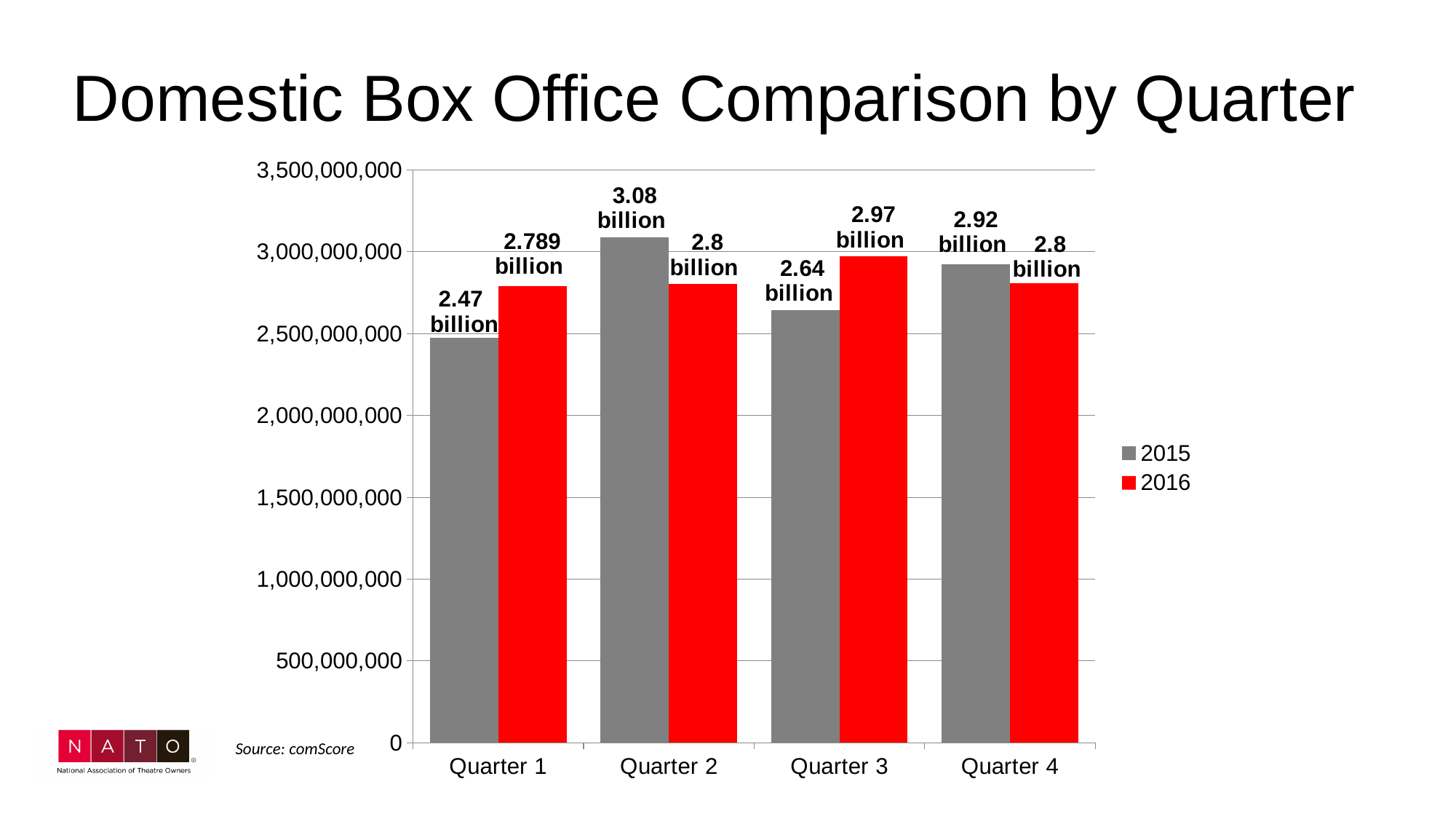
Which quarter has the lowest 2015 value? Quarter 1 Which quarter has the highest 2015 value? Quarter 2 Which quarter has the highest 2016 value? Quarter 3 What is the difference between the 2015 and 2016 values for Quarter 3? 0.33 billion How many quarters are shown on the x axis? 4 How many series does the legend list? 2 What is the 2016 value for Quarter 3? 2.97 billion What kind of chart is shown on the slide? Bar chart What is the 2015 value for Quarter 1? 2.47 billion What is the 2015 value for Quarter 4? 2.92 billion Which is larger in Quarter 3, the 2015 value or the 2016 value? 2016 What is the 2016 value for Quarter 1? 2.789 billion